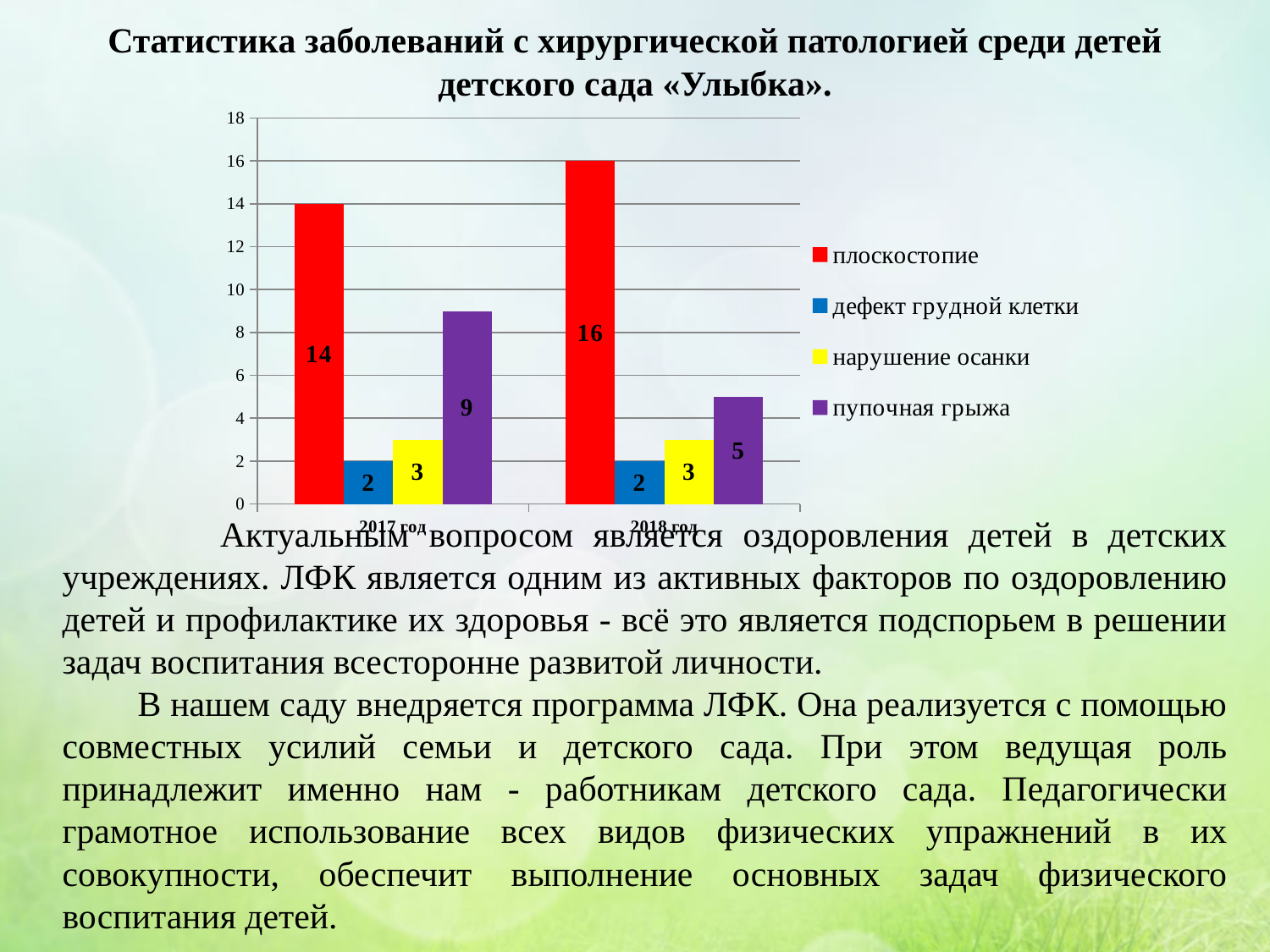
What is the value for пупочная грыжа in 2018 год? 5 Which is larger: пупочная грыжа in 2017 год or пупочная грыжа in 2018 год? 2017 год What is the value for плоскостопие in 2017 год? 14 Which series has the lowest value in 2017 год? дефект грудной клетки How many series does the legend list? 4 What is the value for пупочная грыжа in 2017 год? 9 What colour are the bars for нарушение осанки? yellow What is the value for нарушение осанки in 2018 год? 3 What type of chart is shown on the slide? bar chart Which series has the highest value in 2018 год? плоскостопие What is the value for плоскостопие in 2018 год? 16 What is the difference between the плоскостопие values for 2018 год and 2017 год? 2